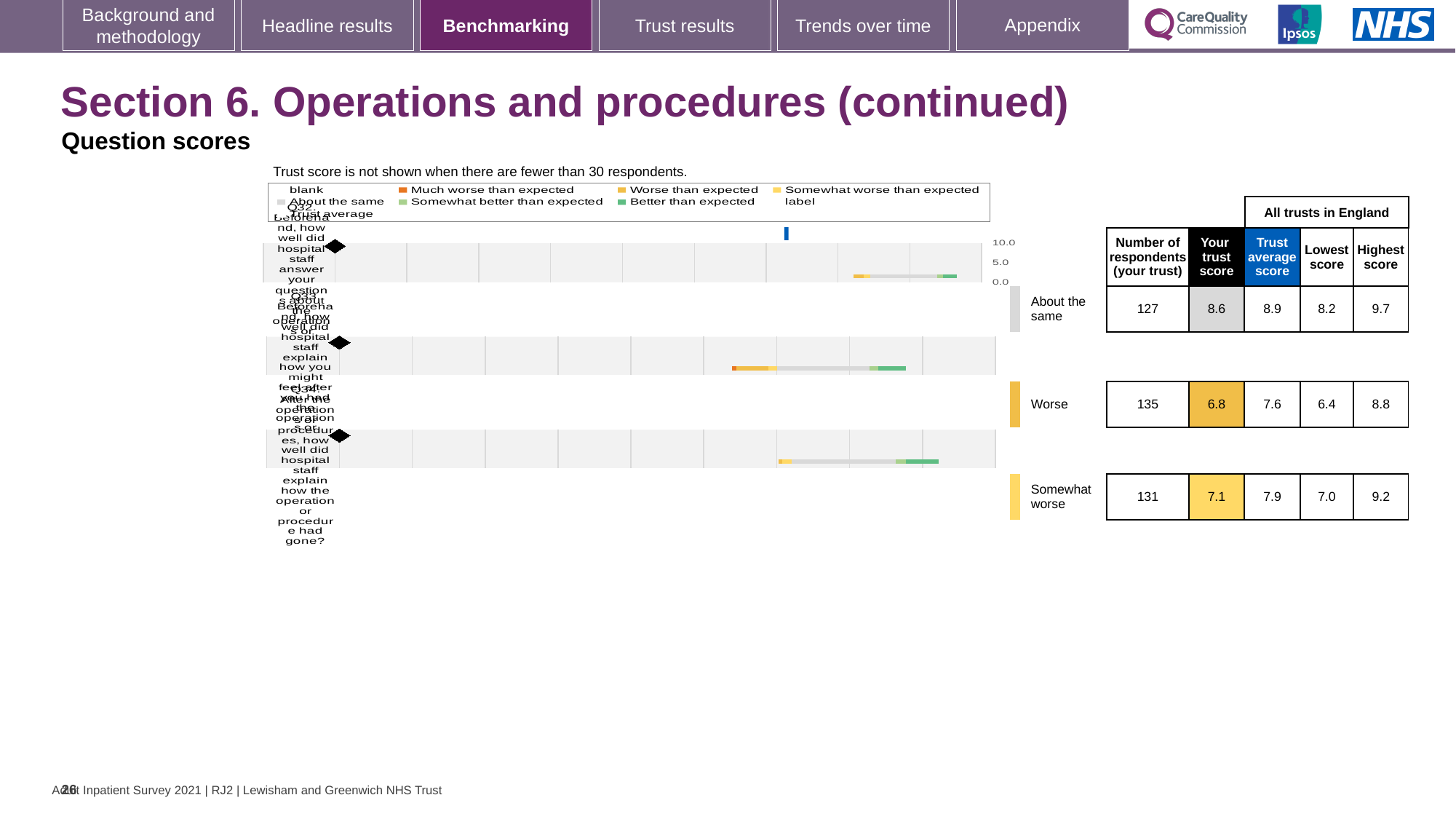
What is the lowest score across all trusts in England for the row labelled 'Worse'? 6.4 What is the number of respondents for the question row labelled 'Worse'? 135 What is the 'Your trust score' for the question row labelled 'Worse'? 6.8 What is the 'Your trust score' for the first question row, labelled 'About the same'? 8.6 What is the highest score across all trusts in England for the question row labelled 'About the same'? 9.7 What is the 'Your trust score' for the question row labelled 'Somewhat worse'? 7.1 How many question rows are shown in the benchmarking chart? 3 Which of the three question rows has the highest 'Your trust score'? About the same What is the trust average score for the question row labelled 'Somewhat worse'? 7.9 Is the 'Your trust score' for the row labelled 'Somewhat worse' larger or smaller than the trust average score for that row? smaller Which of the three question rows has the lowest 'Your trust score'? Worse What is the difference between the trust average score and 'Your trust score' for the row labelled 'Worse'? 0.8